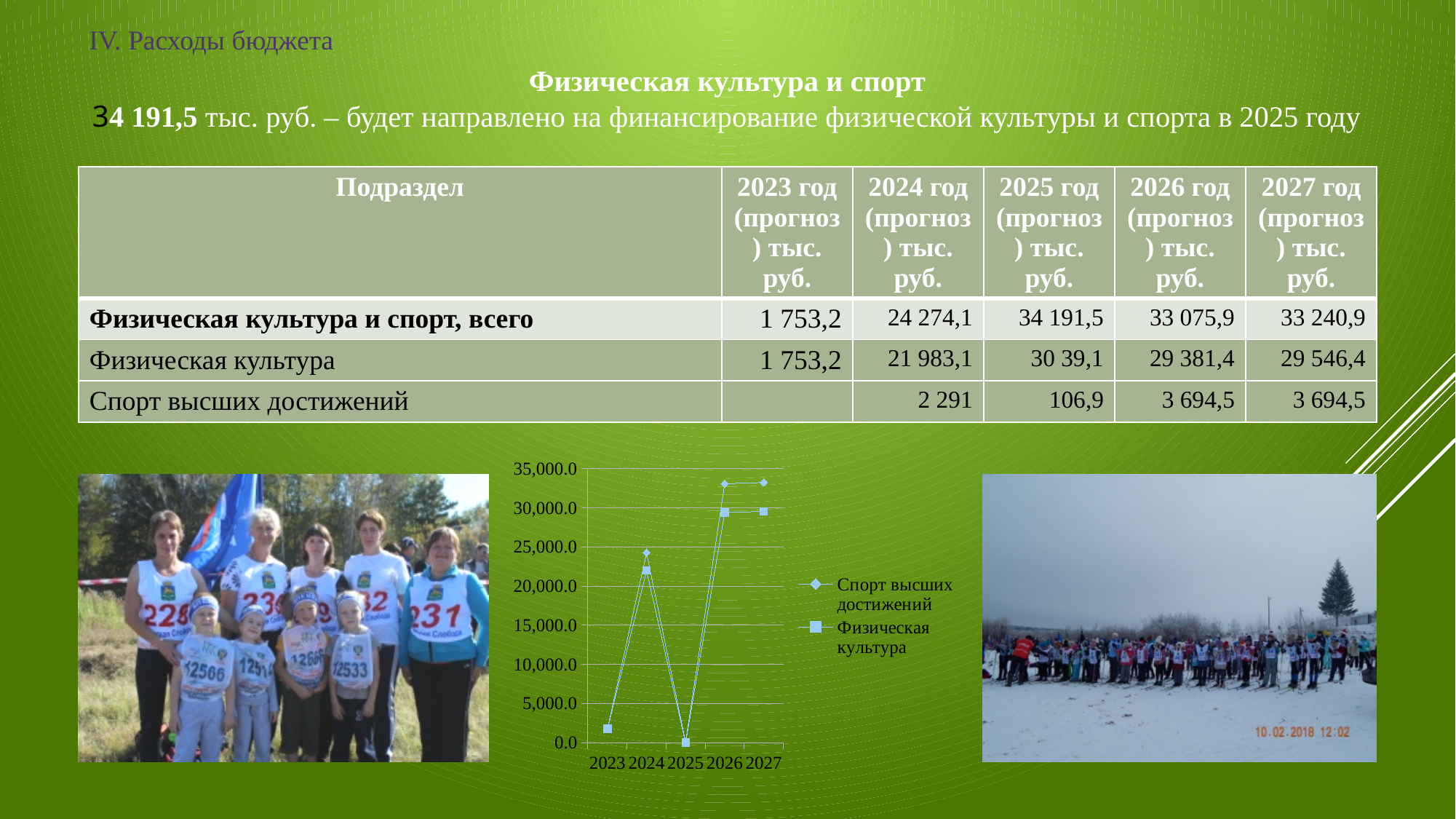
What kind of chart is shown on the slide? line chart Is the value for Спорт высших достижений in 2026 greater or less than 30,000.0? greater Is the value for Физическая культура in 2026 greater or less than 25,000.0? greater Does the Спорт высших достижений line rise or fall from 2025 to 2026? rise How many series does the chart legend list? 2 Is the value for Физическая культура in 2023 greater or less than 5,000.0? less Does the Физическая культура line rise or fall from 2024 to 2025? fall What is the highest value shown on the chart's y axis? 35,000.0 Which two series are listed in the chart legend? Спорт высших достижений and Физическая культура How many years are shown along the x axis of the chart? 5